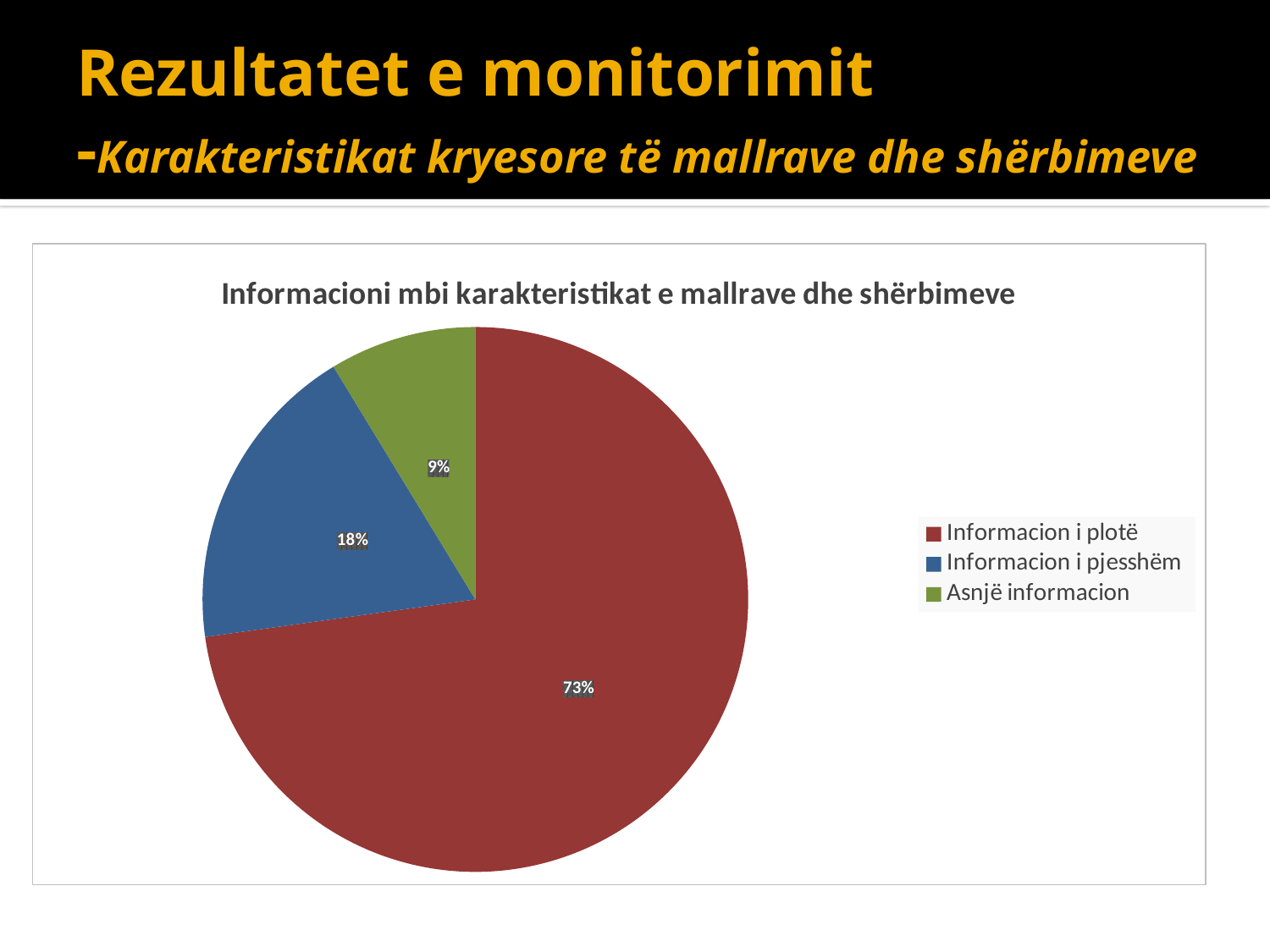
What share of the pie does "Asnjë informacion" represent? 9% What kind of chart is shown on the slide? Pie chart What share of the pie does "Informacion i plotë" represent? 73% What is the title of the chart? Informacioni mbi karakteristikat e mallrave dhe shërbimeve How many categories are shown in the pie chart? 3 What is the difference in percentage points between "Informacion i pjesshëm" and "Asnjë informacion"? 9 Which is larger, the slice for "Informacion i pjesshëm" or the slice for "Asnjë informacion"? Informacion i pjesshëm What share of the pie does "Informacion i pjesshëm" represent? 18% What is the difference in percentage points between "Informacion i plotë" and "Informacion i pjesshëm"? 55 Which category has the largest slice of the pie? Informacion i plotë Which category has the smallest slice of the pie? Asnjë informacion What colour is the slice for "Asnjë informacion"? Green